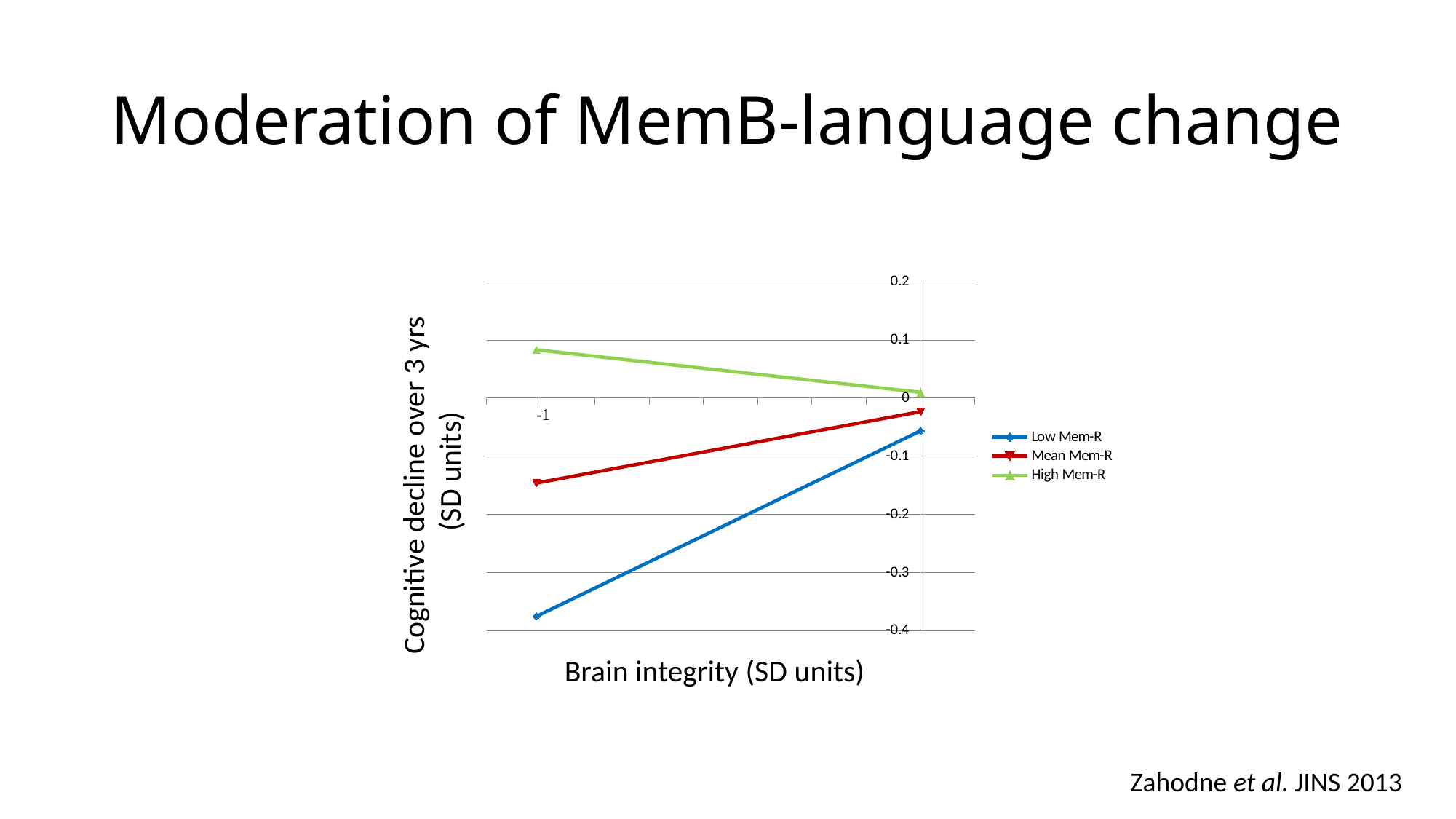
Is the value for High Mem-R at brain integrity -1 greater or less than 0? greater Is the value for Mean Mem-R at brain integrity -1 greater or less than -0.1? less Is the value for Low Mem-R at brain integrity -1 greater or less than -0.3? less Which series has the highest value at brain integrity -1? High Mem-R Does the Low Mem-R line rise or fall as brain integrity increases from -1 to 0? rise What is the title of the x axis? Brain integrity (SD units) Does the High Mem-R line rise or fall as brain integrity increases from -1 to 0? fall Which series has the lowest value at brain integrity -1? Low Mem-R Which series is drawn in green? High Mem-R What kind of chart is shown on the slide? line chart At brain integrity -1, which is larger: the value for Mean Mem-R or the value for Low Mem-R? Mean Mem-R How many series does the legend list? 3